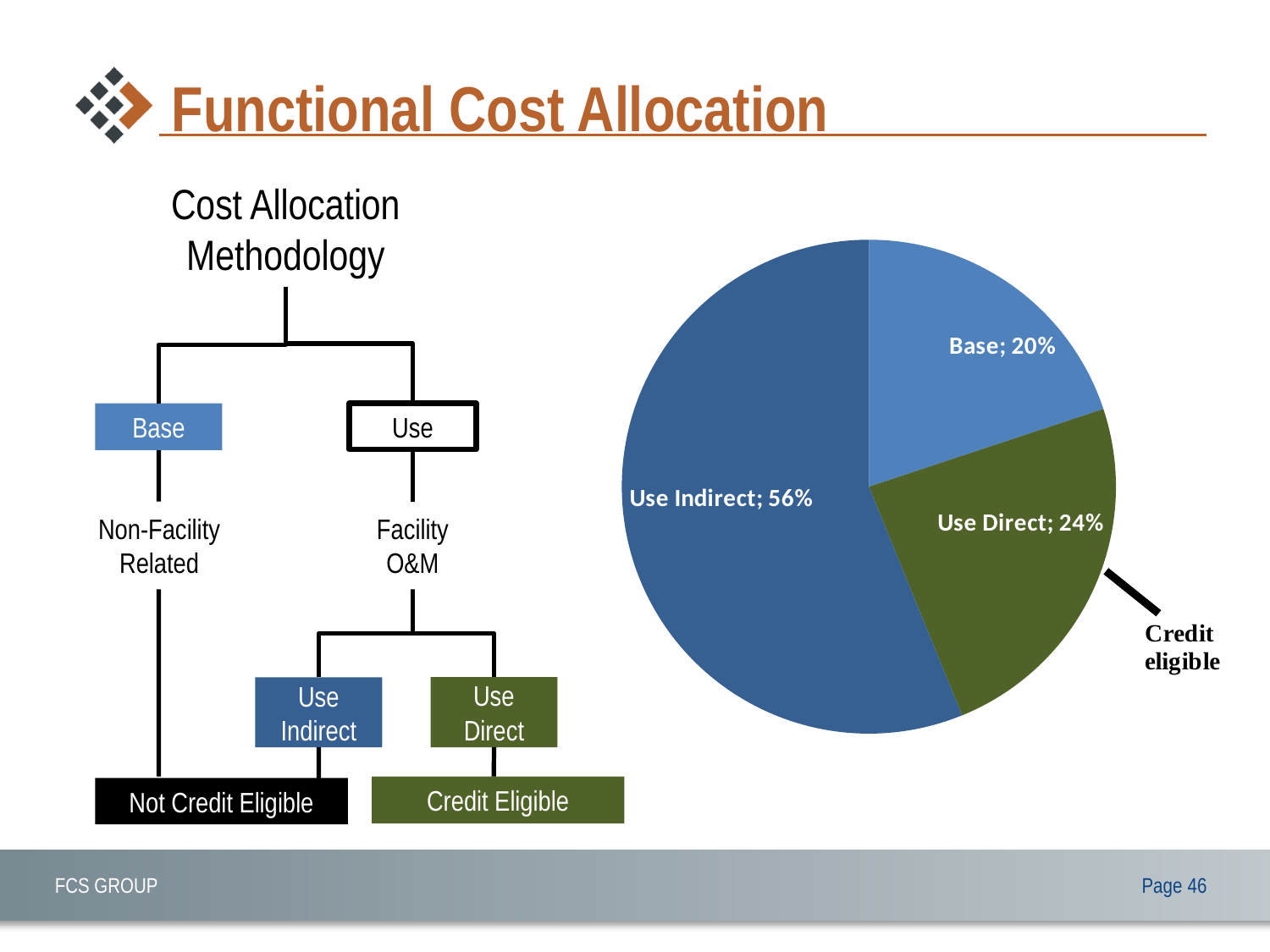
Which slice of the pie chart is the smallest? Base In the pie chart, what is the combined share of Use Direct and Use Indirect? 80% In the pie chart, which is larger, Base or Use Direct? Use Direct What colour is the Use Direct slice in the pie chart? green How many slices does the pie chart have? 3 In the pie chart, what share is labelled for Use Direct? 24% Which slice of the pie chart is the largest? Use Indirect In the pie chart, what is the difference between the Use Indirect share and the Use Direct share? 32% In the pie chart, what share is labelled for Use Indirect? 56% In the pie chart, what share is labelled for Base? 20% Which slice of the pie chart is annotated as "Credit eligible"? Use Direct What kind of chart is shown on the right side of the slide? pie chart